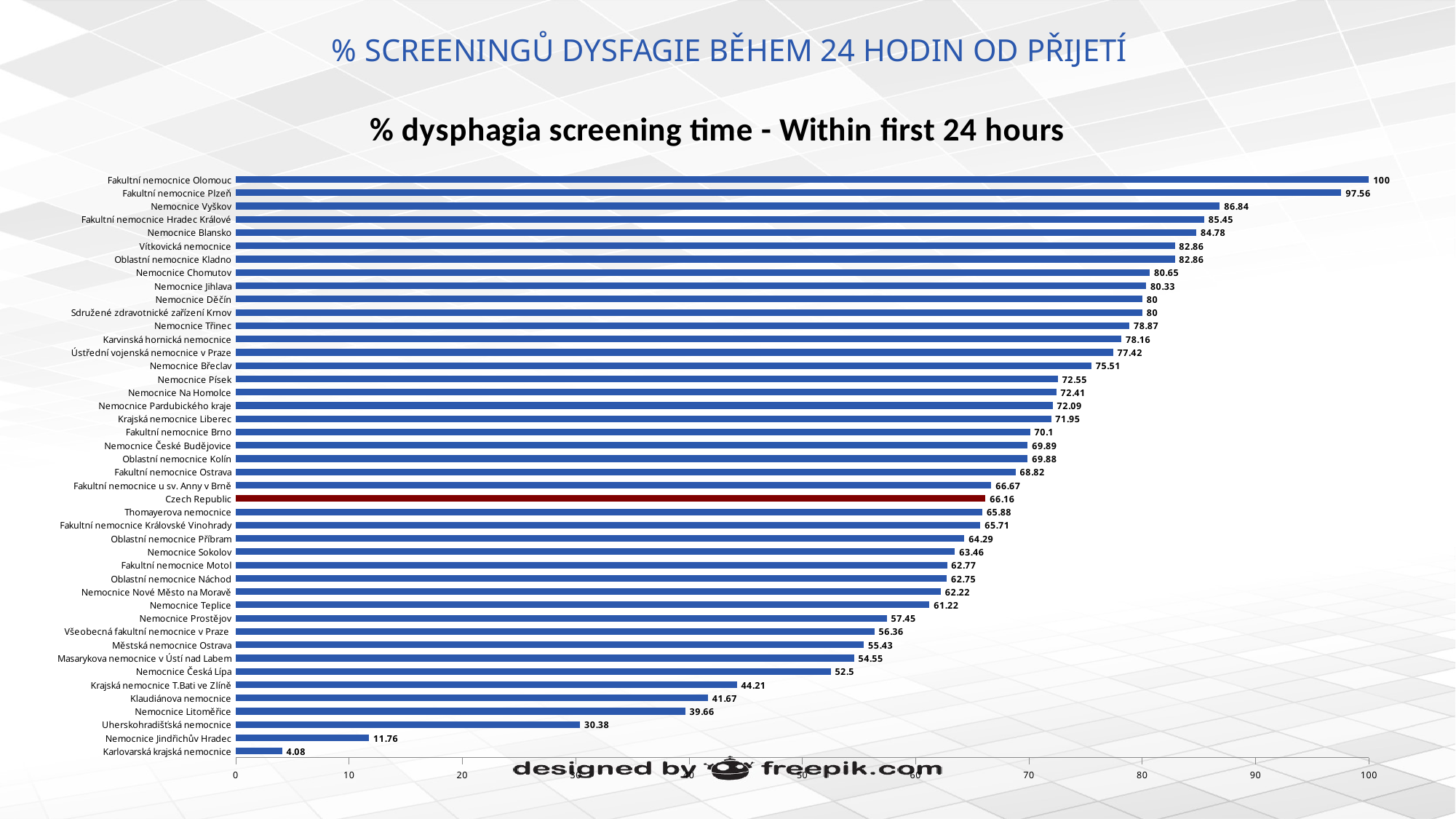
Is the value for Uherskohradišťská nemocnice greater or less than 40? less What is the title of the chart? % dysphagia screening time - Within first 24 hours What is the value for Nemocnice Jindřichův Hradec? 11.76 Which hospital has the lowest value? Karlovarská krajská nemocnice How many hospitals/categories are plotted in the chart? 44 What kind of chart is shown on the slide? bar chart What is the value for Czech Republic? 66.16 Which hospital has the highest value? Fakultní nemocnice Olomouc What is the value for Fakultní nemocnice Motol? 62.77 What is the difference between the values for Fakultní nemocnice Olomouc and Fakultní nemocnice Plzeň? 2.44 Which is larger, the value for Nemocnice Vyškov or the value for Nemocnice Blansko? Nemocnice Vyškov Which bar is coloured differently (red) from the others? Czech Republic